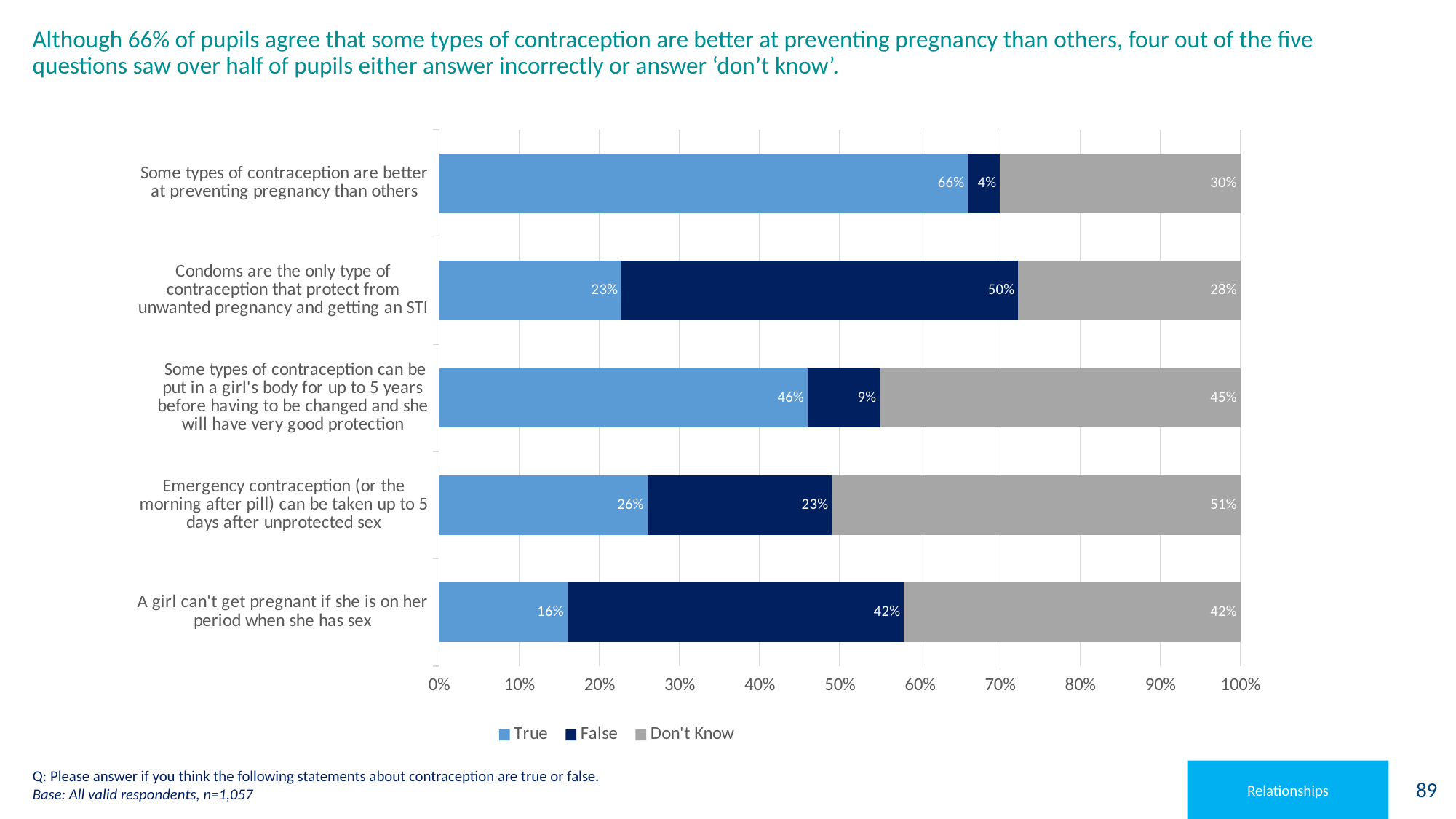
How many statements are shown in the chart? 5 Which statement has the lowest 'True' percentage? A girl can't get pregnant if she is on her period when she has sex What percentage of pupils answered 'False' to the statement 'Condoms are the only type of contraception that protect from unwanted pregnancy and getting an STI'? 50% What is the difference between the 'False' and 'True' percentages for the statement 'A girl can't get pregnant if she is on her period when she has sex'? 26% Which statement has the highest 'Don't Know' percentage? Emergency contraception (or the morning after pill) can be taken up to 5 days after unprotected sex What type of chart is shown on the slide? Stacked bar chart Is the 'True' percentage higher for 'Some types of contraception can be put in a girl's body for up to 5 years...' or for 'Emergency contraception (or the morning after pill) can be taken up to 5 days after unprotected sex'? Some types of contraception can be put in a girl's body for up to 5 years before having to be changed and she will have very good protection What is the combined percentage of 'True' and 'False' answers for the statement 'Condoms are the only type of contraception that protect from unwanted pregnancy and getting an STI'? 73% Which colour represents the 'Don't Know' series in the chart? Grey How many series does the legend list? 3 What percentage of pupils answered 'Don't Know' to the statement 'Emergency contraception (or the morning after pill) can be taken up to 5 days after unprotected sex'? 51% What percentage of pupils answered 'True' to the statement 'Some types of contraception are better at preventing pregnancy than others'? 66%